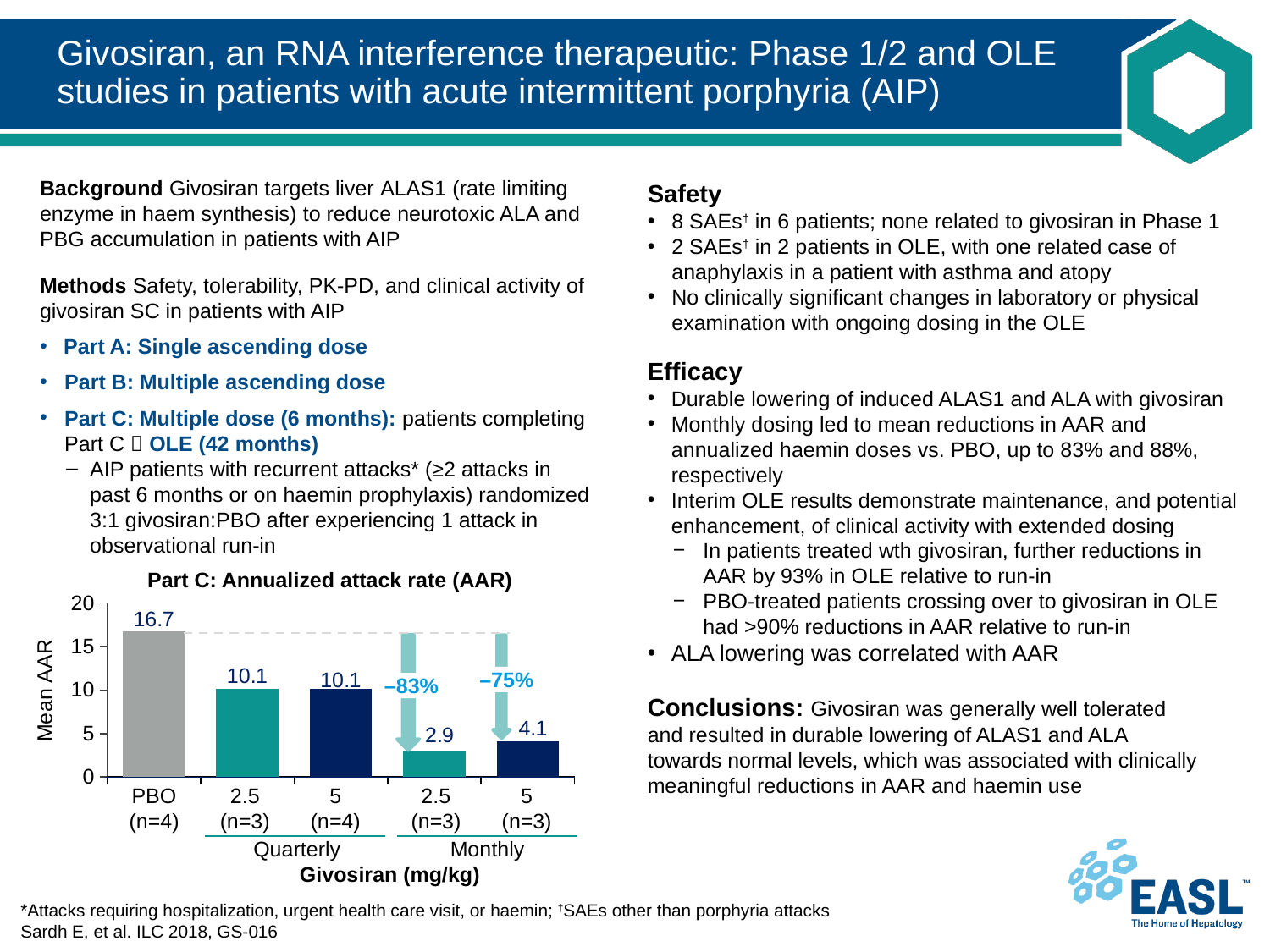
Which group has the highest mean AAR in the chart? PBO (n=4) What percentage reduction is annotated above the monthly 2.5 mg/kg bar? −83% What is the mean AAR for the quarterly 5 mg/kg givosiran group? 10.1 Which has a larger mean AAR: the monthly 5 mg/kg group or the quarterly 5 mg/kg group? Quarterly 5 mg/kg What is the difference in mean AAR between the PBO group and the quarterly 2.5 mg/kg group? 6.6 Which group has the lowest mean AAR in the chart? Monthly 2.5 mg/kg (n=3) What is the mean AAR for the PBO (n=4) group in the Part C: Annualized attack rate (AAR) chart? 16.7 What is the label of the y-axis in the Part C: Annualized attack rate (AAR) chart? Mean AAR How many bars are shown in the Part C: Annualized attack rate (AAR) chart? 5 What type of chart is used to show the Part C annualized attack rate? Bar chart What is the mean AAR for the monthly 2.5 mg/kg givosiran group? 2.9 What is the mean AAR for the monthly 5 mg/kg givosiran group? 4.1